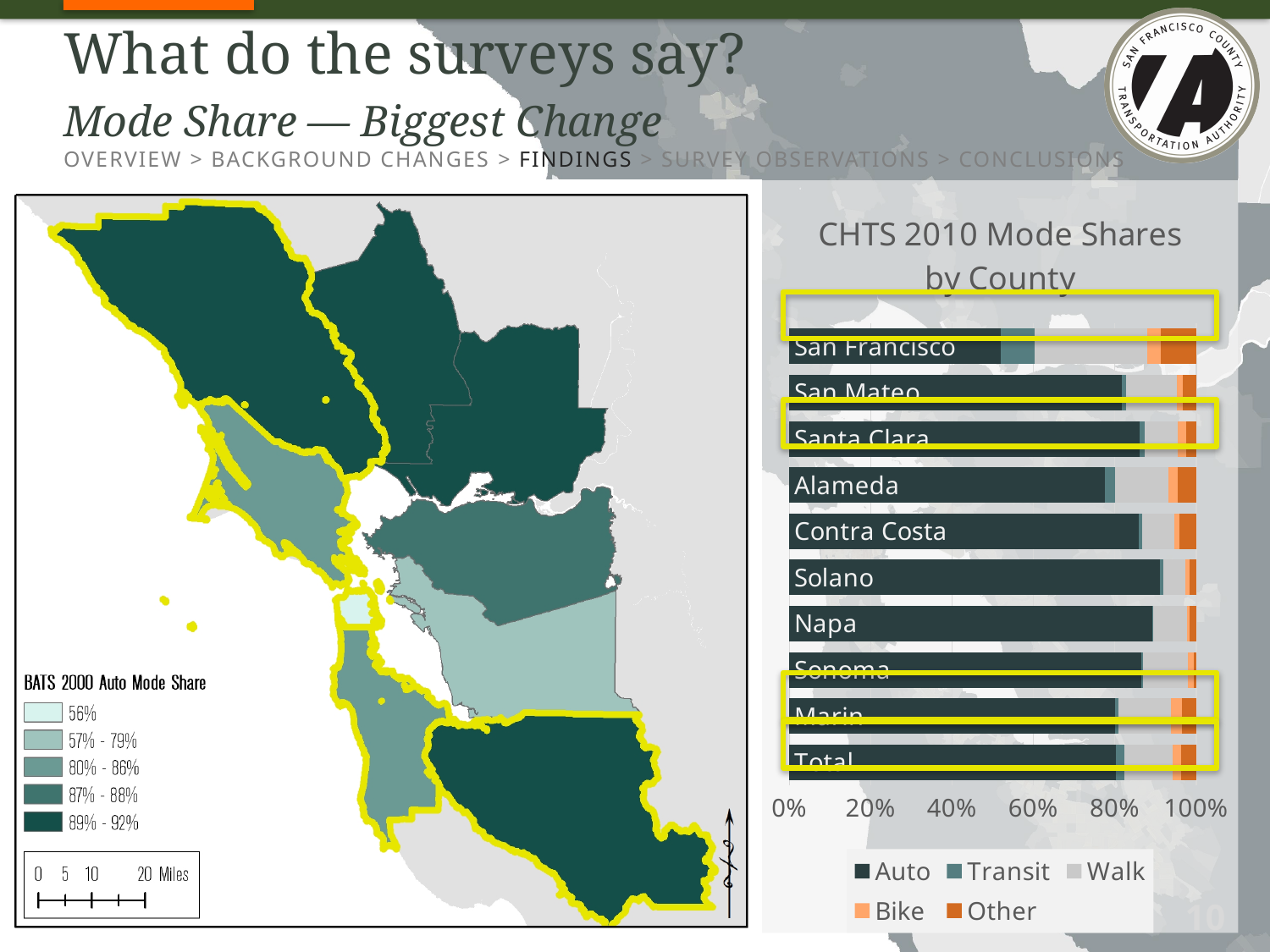
What kind of chart is the 'CHTS 2010 Mode Shares by County' chart? Stacked bar chart In the 'CHTS 2010 Mode Shares by County' chart, which has the larger Auto share, San Francisco or Solano? Solano How many series does the legend of the 'CHTS 2010 Mode Shares by County' chart list? 5 In the 'CHTS 2010 Mode Shares by County' chart, which series is shown in the darkest green colour? Auto How many counties (including Total) are shown as bars in the 'CHTS 2010 Mode Shares by County' chart? 10 In the 'CHTS 2010 Mode Shares by County' chart, which county has the largest Transit mode share? San Francisco In the 'CHTS 2010 Mode Shares by County' chart, is the Auto share for San Francisco greater or less than 60%? less In the 'CHTS 2010 Mode Shares by County' chart, which county has the lowest Auto mode share? San Francisco In the 'CHTS 2010 Mode Shares by County' chart, is the Auto share for Alameda greater or less than 80%? less What is the title of the bar chart on the right side of the slide? CHTS 2010 Mode Shares by County In the 'CHTS 2010 Mode Shares by County' chart, is the Auto share for Solano greater or less than 80%? greater